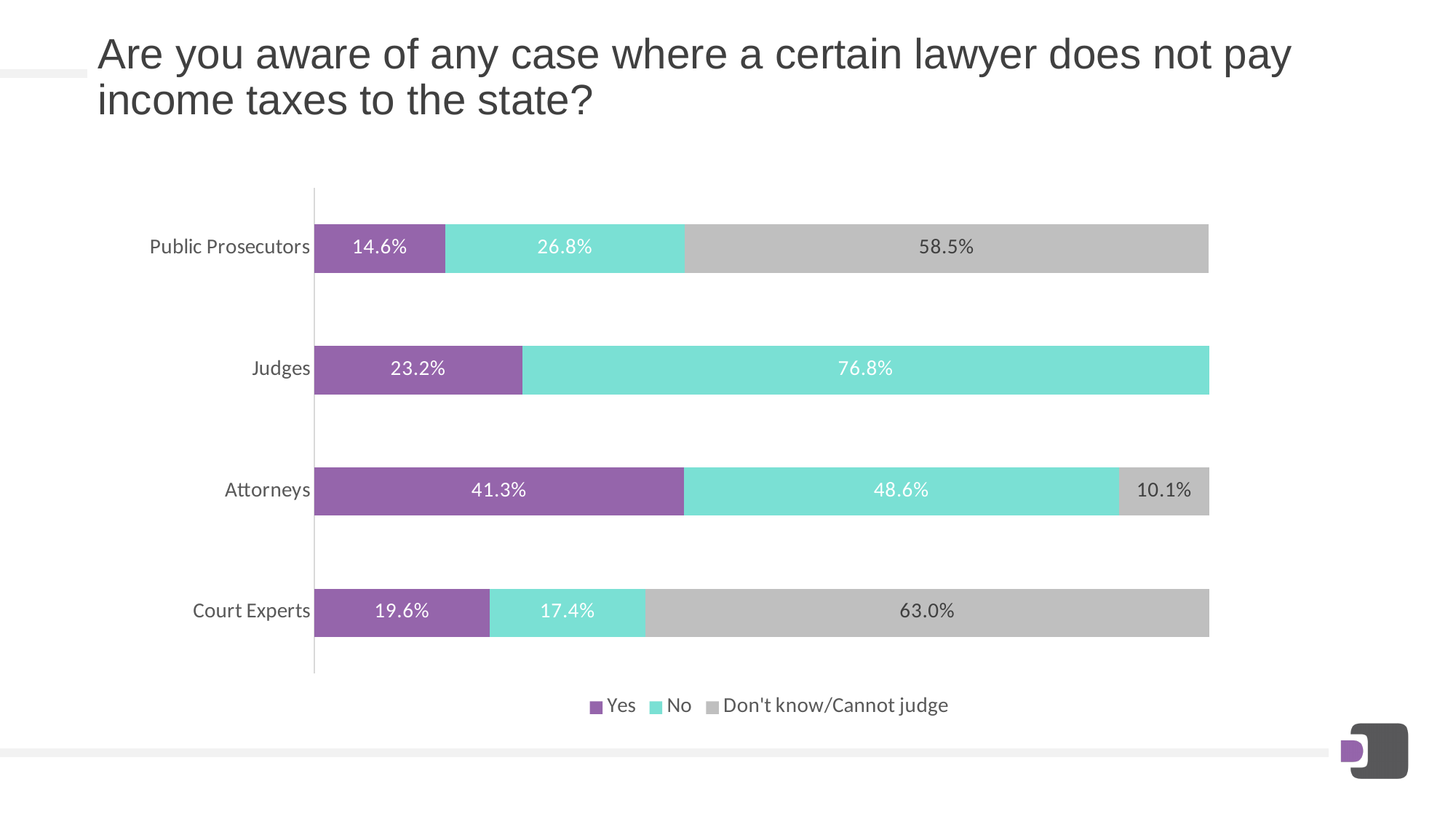
Which colour represents the "No" series in the chart? Teal Which is larger: the "Don't know/Cannot judge" share for Public Prosecutors or for Court Experts? Court Experts What percentage of Attorneys answered "Don't know/Cannot judge"? 10.1% What percentage of Court Experts answered "Don't know/Cannot judge"? 63.0% Which group has the lowest "Yes" percentage? Public Prosecutors How many series does the legend list? 3 Which group has the highest "Yes" percentage? Attorneys What percentage of Public Prosecutors answered "Yes"? 14.6% What percentage of Judges answered "No"? 76.8% What is the difference between the "No" percentages for Judges and Attorneys? 28.2% What kind of chart is shown on the slide? Stacked bar chart How many groups are shown on the chart? 4